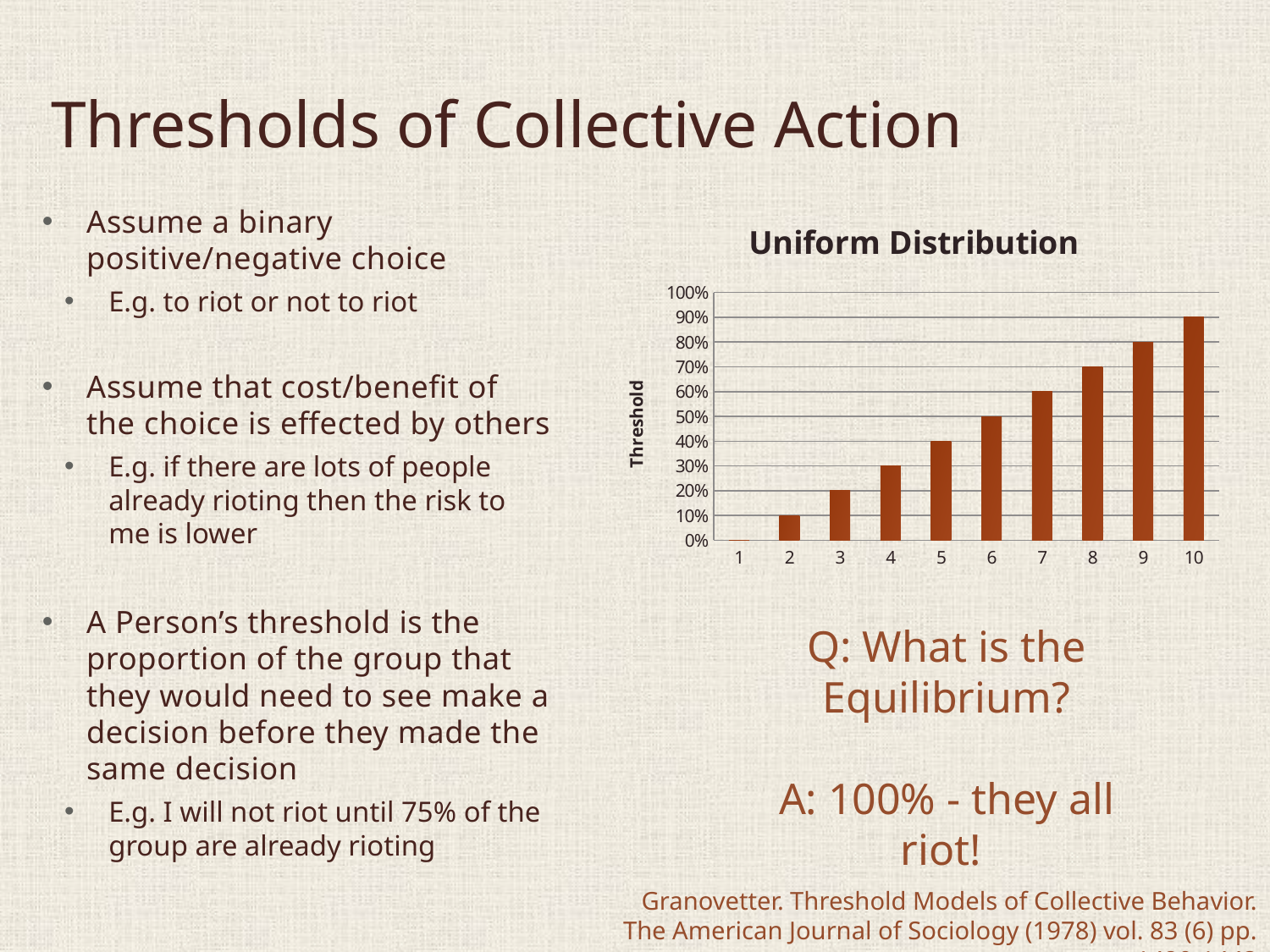
What is the threshold value for category 2? 10% What is the difference between the threshold values for category 8 and category 3? 50% What is the threshold value for category 10? 90% Which has a larger threshold value, category 4 or category 7? category 7 What is the threshold value for category 5? 40% Which category has the lowest threshold value? 1 What is the label on the vertical axis of the chart? Threshold How many categories are shown along the x axis of the chart? 10 What is the title of the chart on the slide? Uniform Distribution What kind of chart is shown under the title "Uniform Distribution"? bar chart Do the threshold values rise or fall as you move from category 1 to category 10? rise Which category has the highest threshold value? 10